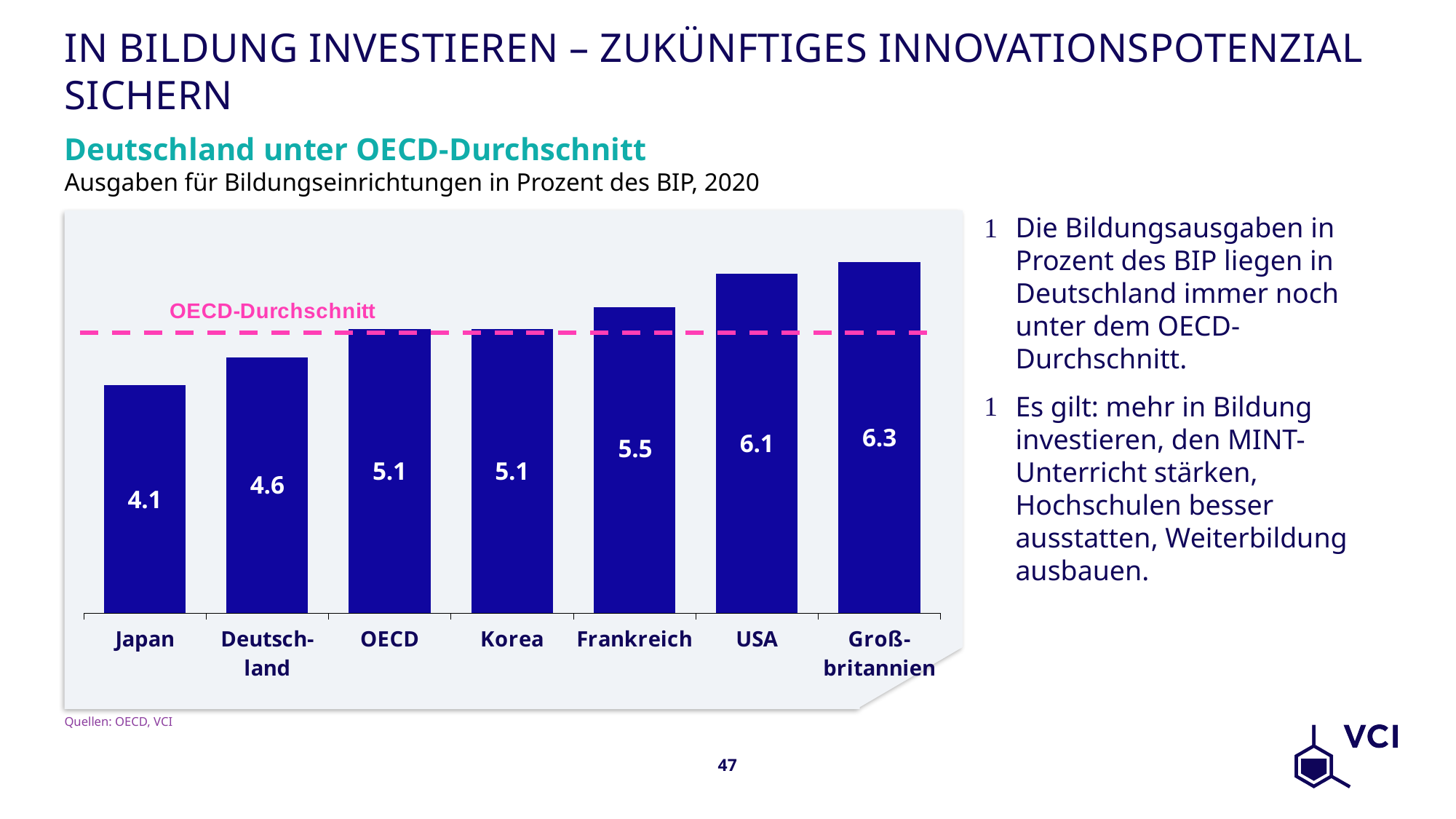
How many categories are shown on the x axis? 7 Which category has the highest value? Großbritannien What is the difference between the OECD value and the value for Deutschland? 0.5 What is the difference between the values for Großbritannien and Japan? 2.2 What kind of chart is this? Bar chart What is the value for Frankreich? 5.5 Which is larger, the value for Frankreich or the value for Korea? Frankreich Do the values rise or fall from left to right along the x axis? Rise What is the value for USA? 6.1 Which category has the lowest value? Japan What does the pink dashed line represent? OECD-Durchschnitt What is the value for Deutschland? 4.6